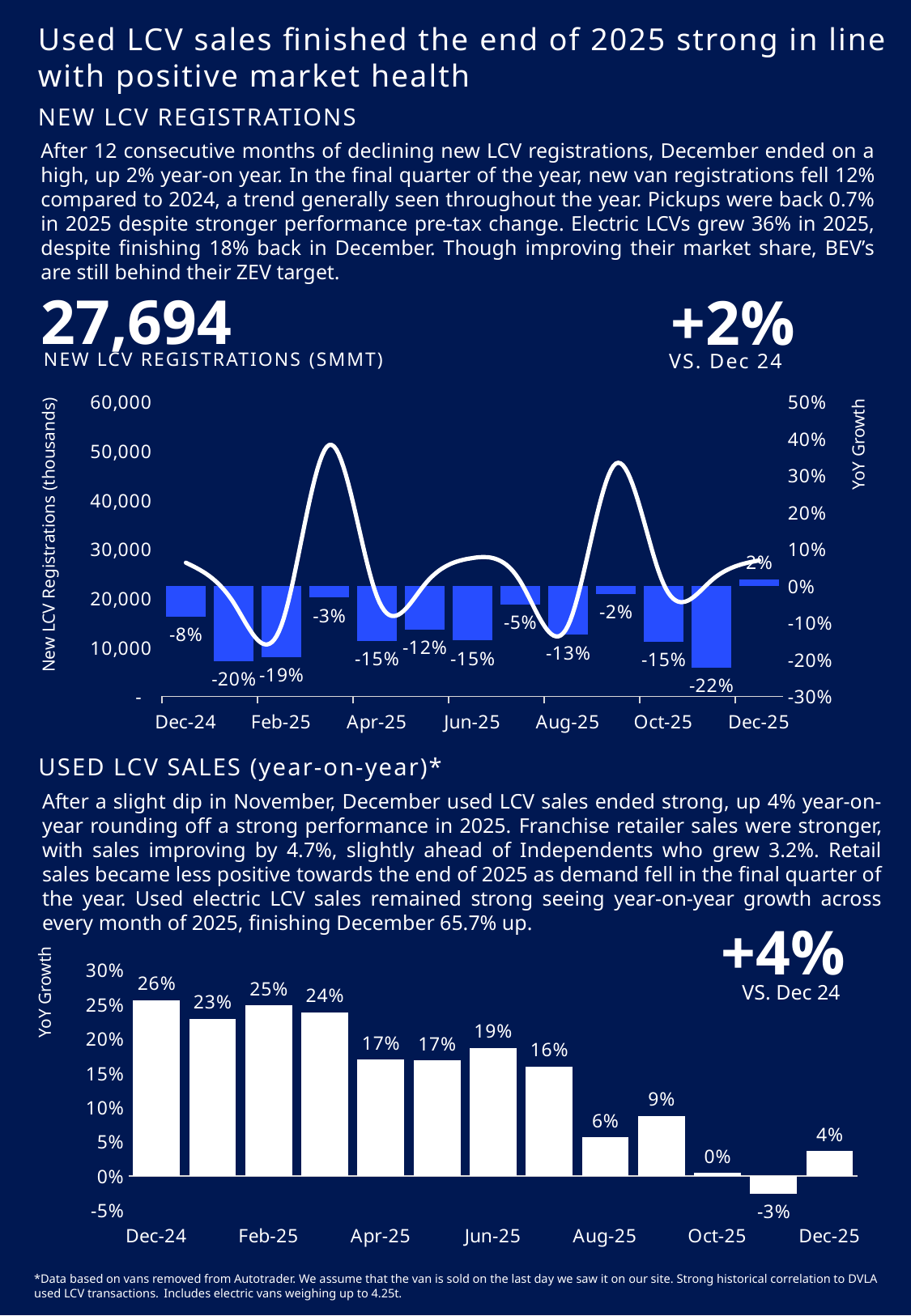
In the NEW LCV REGISTRATIONS chart, which has the higher YoY growth value, Dec-24 or Oct-25? Dec-24 What kind of chart is the USED LCV SALES (year-on-year) chart? Bar chart In the USED LCV SALES (year-on-year) chart, what is the lowest YoY growth value shown? -3% In the NEW LCV REGISTRATIONS chart, what is the YoY growth value for Dec-25? 2% In the USED LCV SALES (year-on-year) chart, do the values generally rise or fall from Dec-24 to Dec-25? Fall In the USED LCV SALES (year-on-year) chart, what is the YoY growth value for Dec-25? 4% How many bars are plotted in the USED LCV SALES (year-on-year) chart? 13 In the NEW LCV REGISTRATIONS chart, what is the lowest YoY growth value shown on the bars? -22% In the NEW LCV REGISTRATIONS chart, what is the YoY growth value for Feb-25? -19% In the USED LCV SALES (year-on-year) chart, what is the YoY growth value for Dec-24? 26% In the USED LCV SALES (year-on-year) chart, which month has the highest YoY growth? Dec-24 In the USED LCV SALES (year-on-year) chart, what is the difference between the Dec-24 value and the Dec-25 value? 22 percentage points